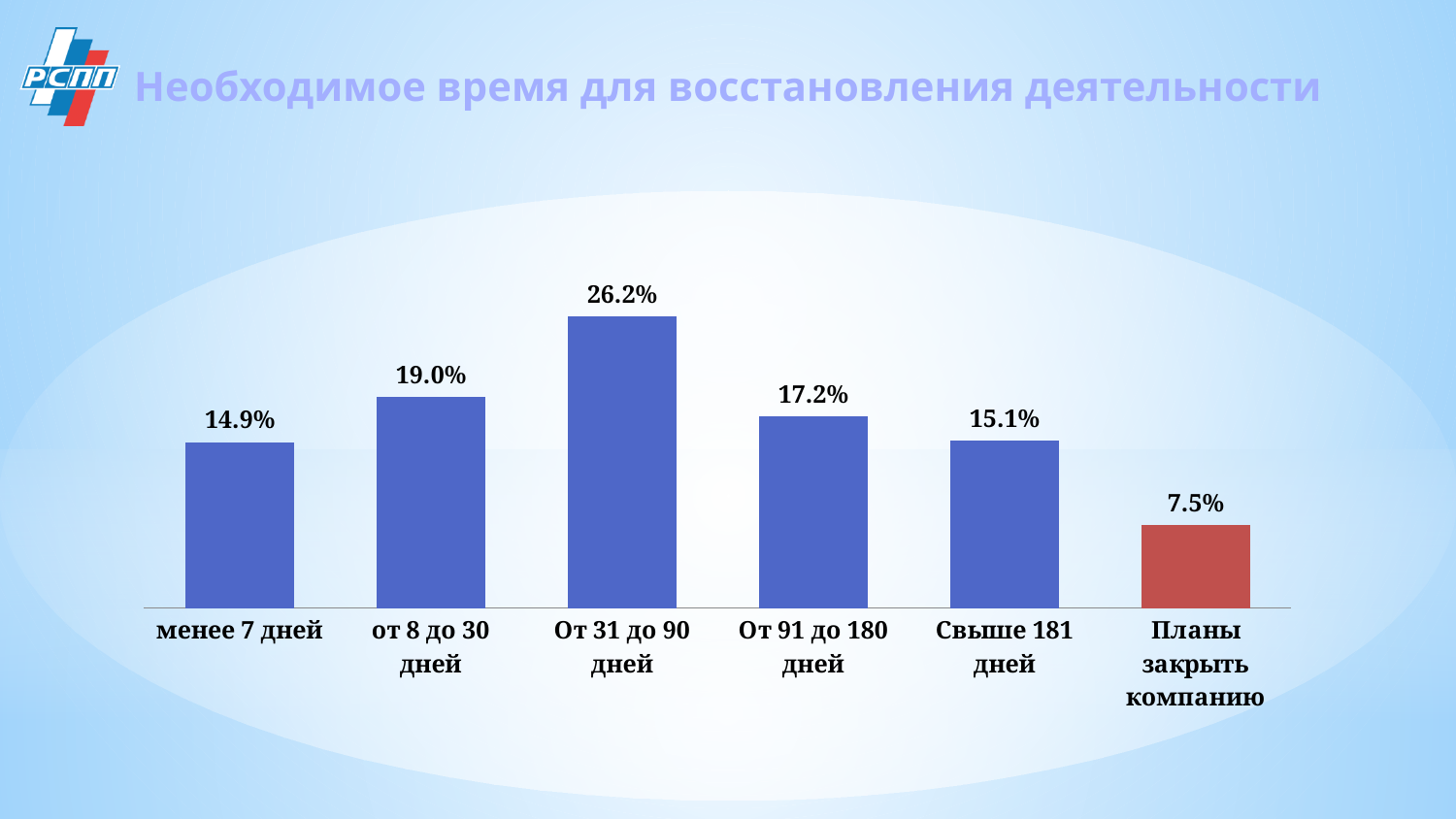
Which category has the lowest value? Планы закрыть компанию What is the difference between the values for "От 31 до 90 дней" and "от 8 до 30 дней"? 7.2% How many categories are shown in the chart? 6 What is the value for "Планы закрыть компанию"? 7.5% Which is larger: the value for "от 8 до 30 дней" or the value for "От 91 до 180 дней"? от 8 до 30 дней What is the value for "менее 7 дней"? 14.9% What type of chart is shown on the slide? Bar chart What is the value for "От 31 до 90 дней"? 26.2% Which bar is coloured differently (red) from the others? Планы закрыть компанию Which category has the highest value? От 31 до 90 дней What is the title of the chart on the slide? Необходимое время для восстановления деятельности What is the value for "Свыше 181 дней"? 15.1%